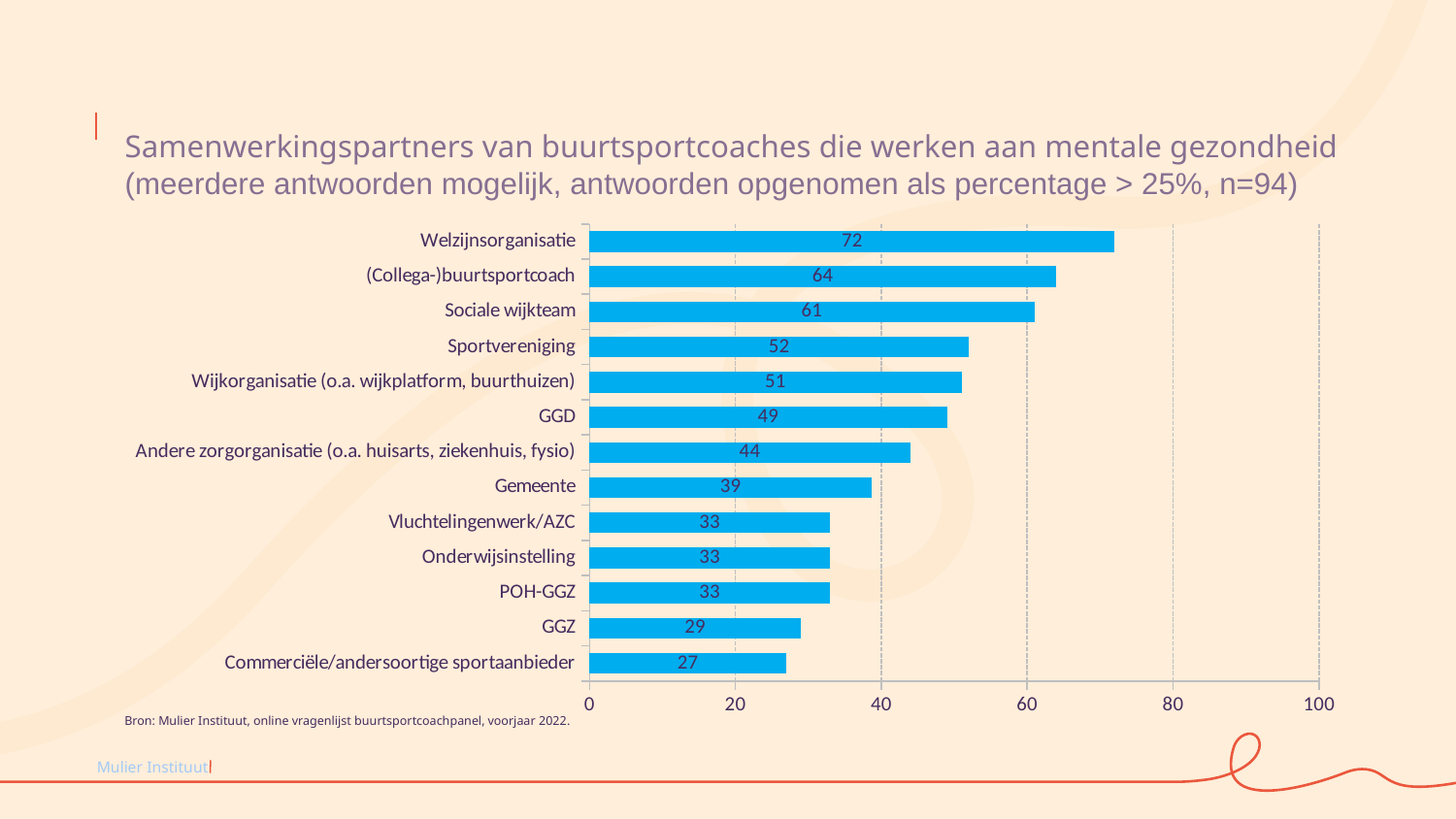
What is the difference between the values for Sportvereniging and GGZ? 23 What is the value for GGD? 49 What kind of chart is shown on the slide? Bar chart What is the value for Gemeente? 39 What is the difference between the values for Welzijnsorganisatie and (Collega-)buurtsportcoach? 8 Which category has the highest value? Welzijnsorganisatie How many categories are shown in the chart? 13 What is the highest value shown on the x axis? 100 What is the value for Welzijnsorganisatie? 72 Which category has the lowest value? Commerciële/andersoortige sportaanbieder Which is larger, the value for Sociale wijkteam or the value for Sportvereniging? Sociale wijkteam Is the value for Andere zorgorganisatie (o.a. huisarts, ziekenhuis, fysio) greater or less than 40? greater